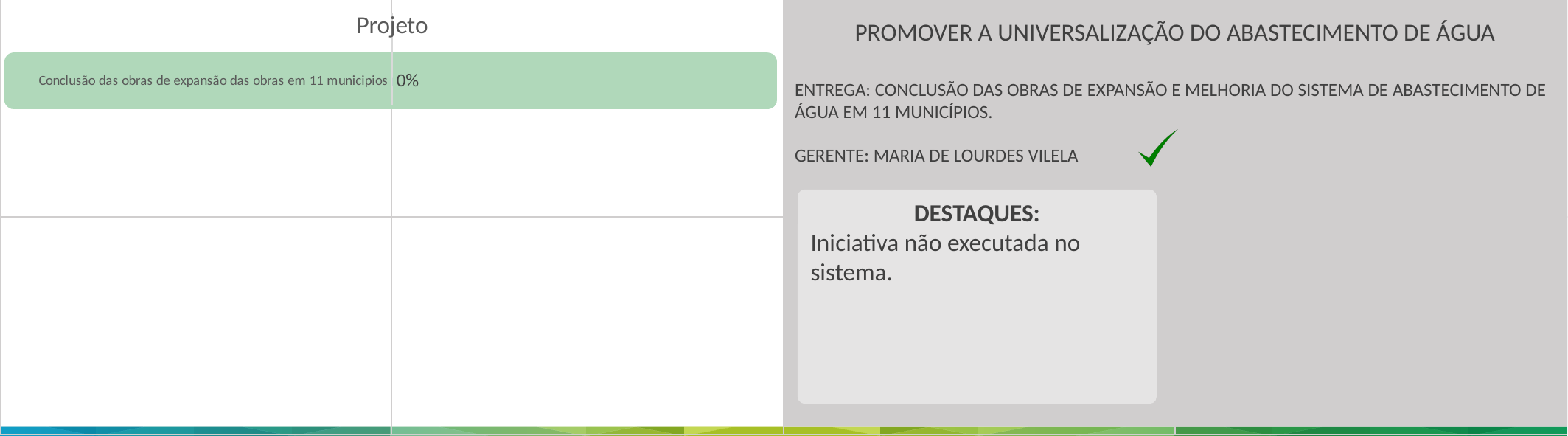
What is the label of the only category in the "Projeto" chart? Conclusão das obras de expansão das obras em 11 municipios What is the title of the chart on the left side of the slide? Projeto In the "Projeto" chart, what value is shown for "Conclusão das obras de expansão das obras em 11 municipios"? 0% What kind of chart is the "Projeto" chart? bar chart How many categories does the "Projeto" chart show? 1